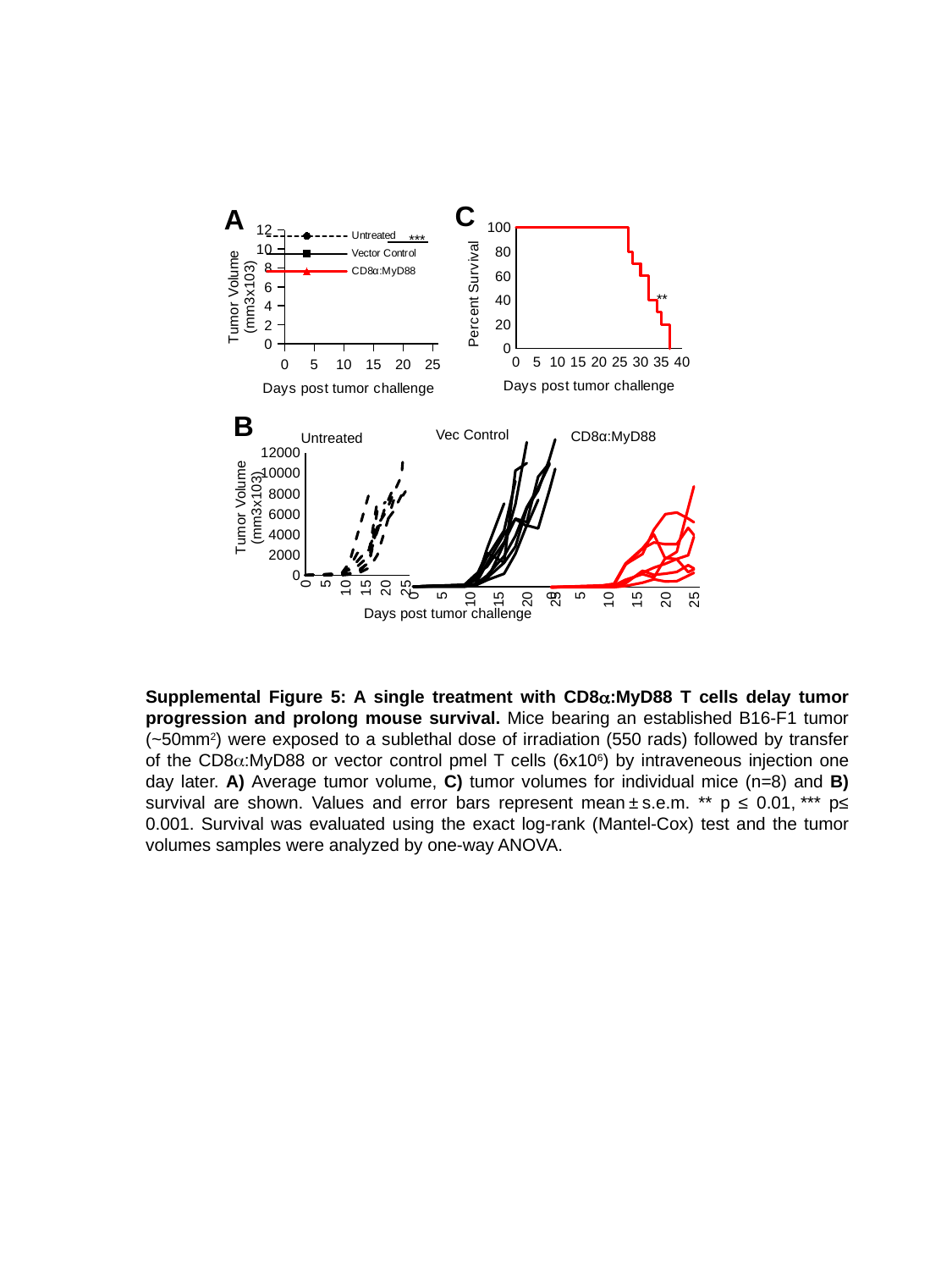
In panel C, what is the percent survival at day 10? 100 In panel B, is the largest tumor volume reached in the CD8α:MyD88 group greater or less than 10000? less In panel C, what is the percent survival at day 20? 100 In panel C, what is the largest tick value on the x axis? 40 In panel C, does percent survival rise or fall as days post tumor challenge increase? Fall What kind of chart is panel C? Line chart In panel B, is the largest tumor volume reached in the Vec Control group greater or less than 10000? greater In panel A, what are the three series named in the legend? Untreated, Vector Control, CD8α:MyD88 In panel B, how many treatment groups are plotted as separate sub-panels? 3 In panel C, is the percent survival at day 35 greater or less than 60? less In panel A, how many series does the legend list? 3 In panel A, what is the highest value shown on the y axis? 12